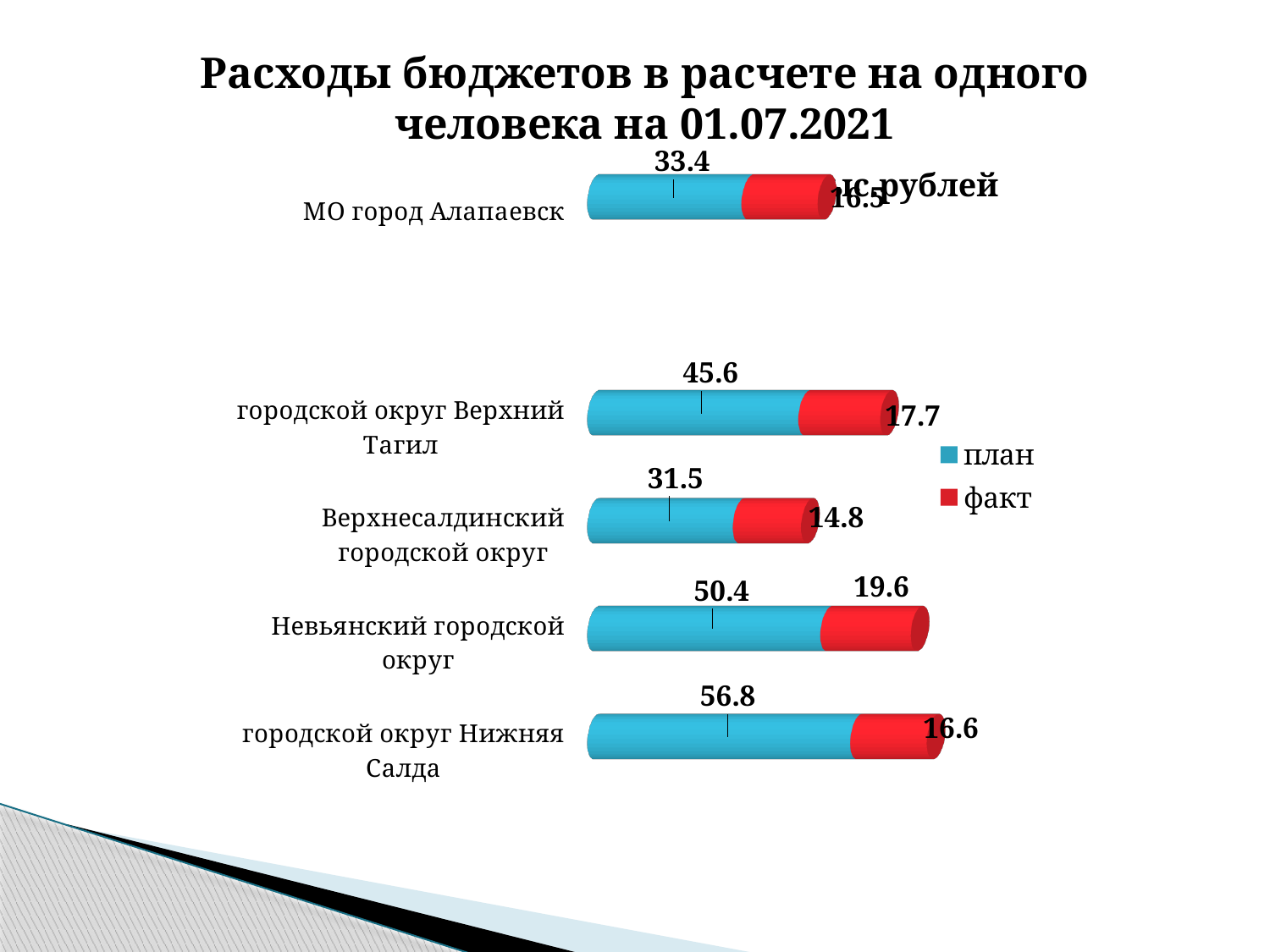
What is the план value for городской округ Верхний Тагил? 45.6 How many categories are shown in the chart? 5 Which category has the highest план value? городской округ Нижняя Салда What is the факт value for Верхнесалдинский городской округ? 14.8 How many series does the legend list? 2 What is the факт value for Невьянский городской округ? 19.6 What is the план value for городской округ Нижняя Салда? 56.8 What type of chart is shown on the slide? bar chart Which category has the lowest план value? Верхнесалдинский городской округ What is the difference between the план and факт values for Невьянский городской округ? 30.8 Which has the larger план value: городской округ Верхний Тагил or Невьянский городской округ? Невьянский городской округ Which category has the highest факт value? Невьянский городской округ